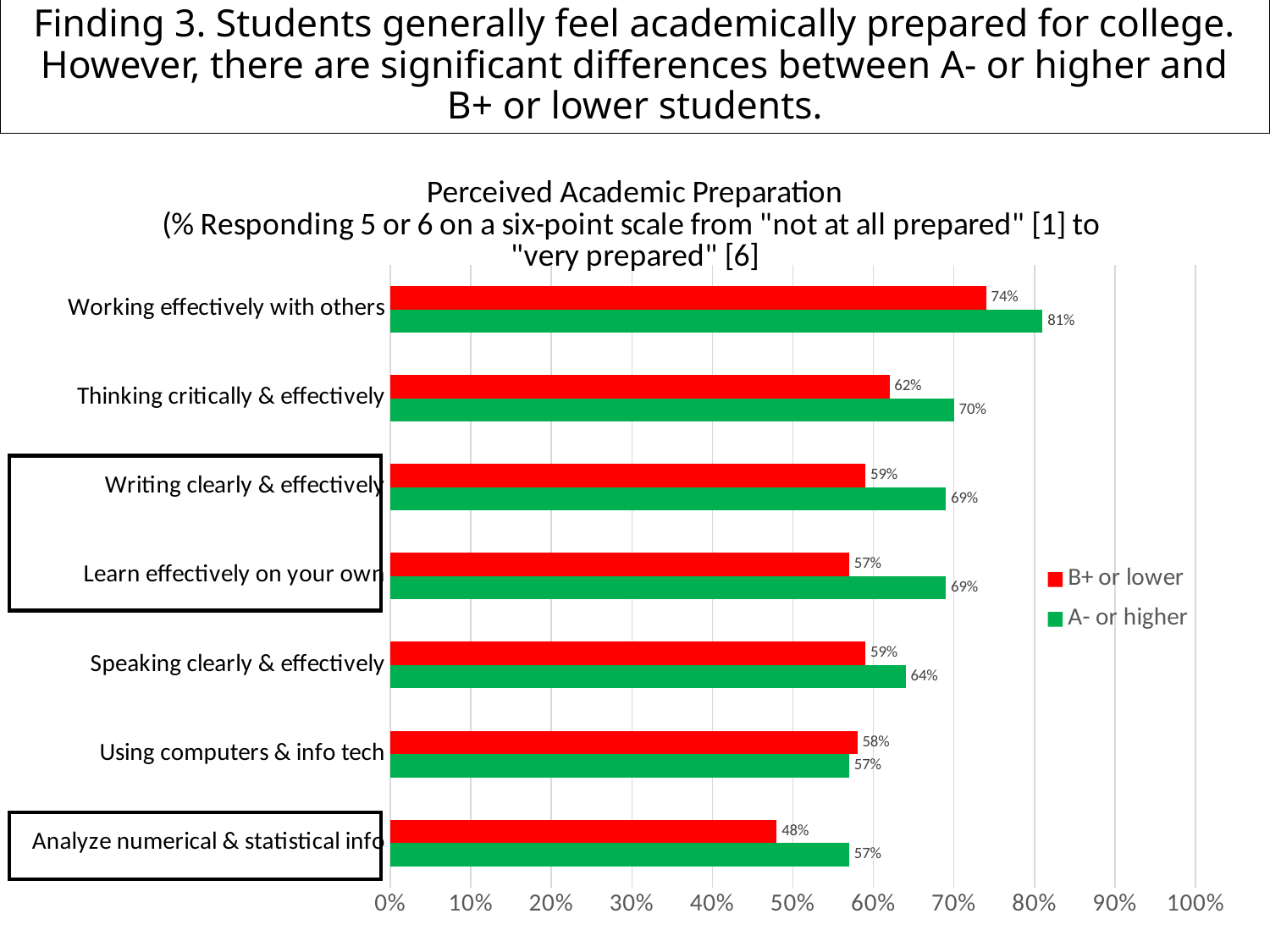
What percentage of B+ or lower students feel prepared for working effectively with others? 74% How many categories are shown on the chart? 7 What is the difference between A- or higher and B+ or lower students for analyzing numerical & statistical info? 9% How many series does the legend list? 2 What kind of chart is shown on the slide? Bar chart For using computers & info tech, which group has the larger value, B+ or lower or A- or higher? B+ or lower Which category has the highest value for A- or higher students? Working effectively with others Which colour represents A- or higher students in the chart? Green Which category has the lowest value for B+ or lower students? Analyze numerical & statistical info What is the value for A- or higher students on speaking clearly & effectively? 64% What percentage of A- or higher students feel prepared for analyzing numerical & statistical info? 57% What is the difference between A- or higher and B+ or lower students for learning effectively on your own? 12%